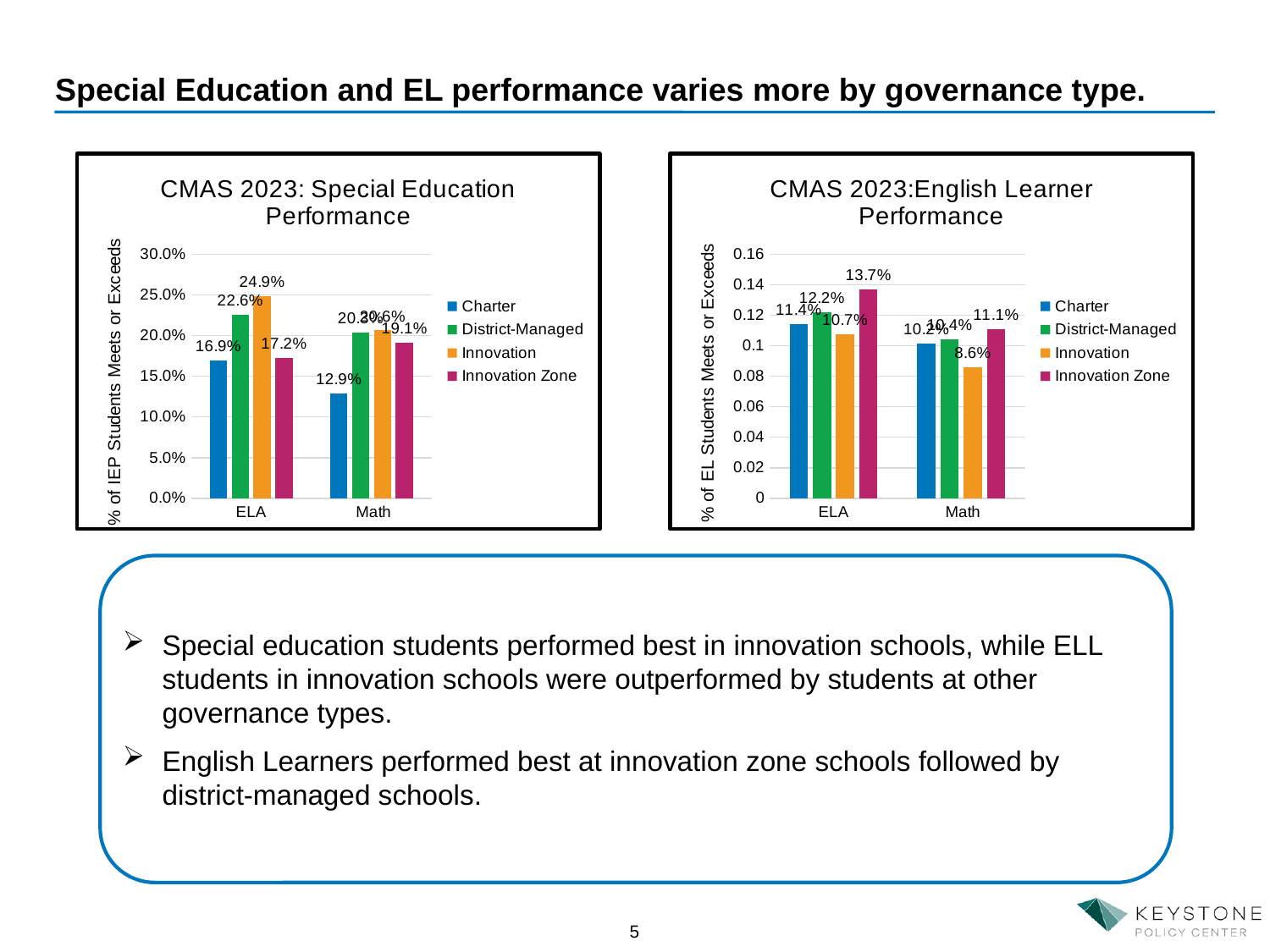
In the CMAS 2023: Special Education Performance chart, which governance type has the lowest Math value? Charter In the CMAS 2023:English Learner Performance chart, which governance type has the lowest Math value? Innovation How many series does the legend of the CMAS 2023:English Learner Performance chart list? 4 In the CMAS 2023: Special Education Performance chart, what is the Math value for Charter? 12.9% In the CMAS 2023: Special Education Performance chart, what is the difference between the Innovation and Charter ELA values? 8.0 percentage points In the CMAS 2023:English Learner Performance chart, what is the ELA value for Innovation Zone? 13.7% In the CMAS 2023:English Learner Performance chart, which governance type has the highest ELA value? Innovation Zone In the CMAS 2023:English Learner Performance chart, what is the difference between the Innovation Zone and Innovation ELA values? 3.0 percentage points In the CMAS 2023: Special Education Performance chart, what is the ELA value for Innovation? 24.9% In the CMAS 2023: Special Education Performance chart, which governance type has the highest ELA value? Innovation In the CMAS 2023:English Learner Performance chart, what is the Math value for Innovation? 8.6% In the CMAS 2023: Special Education Performance chart, is the Charter ELA value greater or less than 20.0%? less